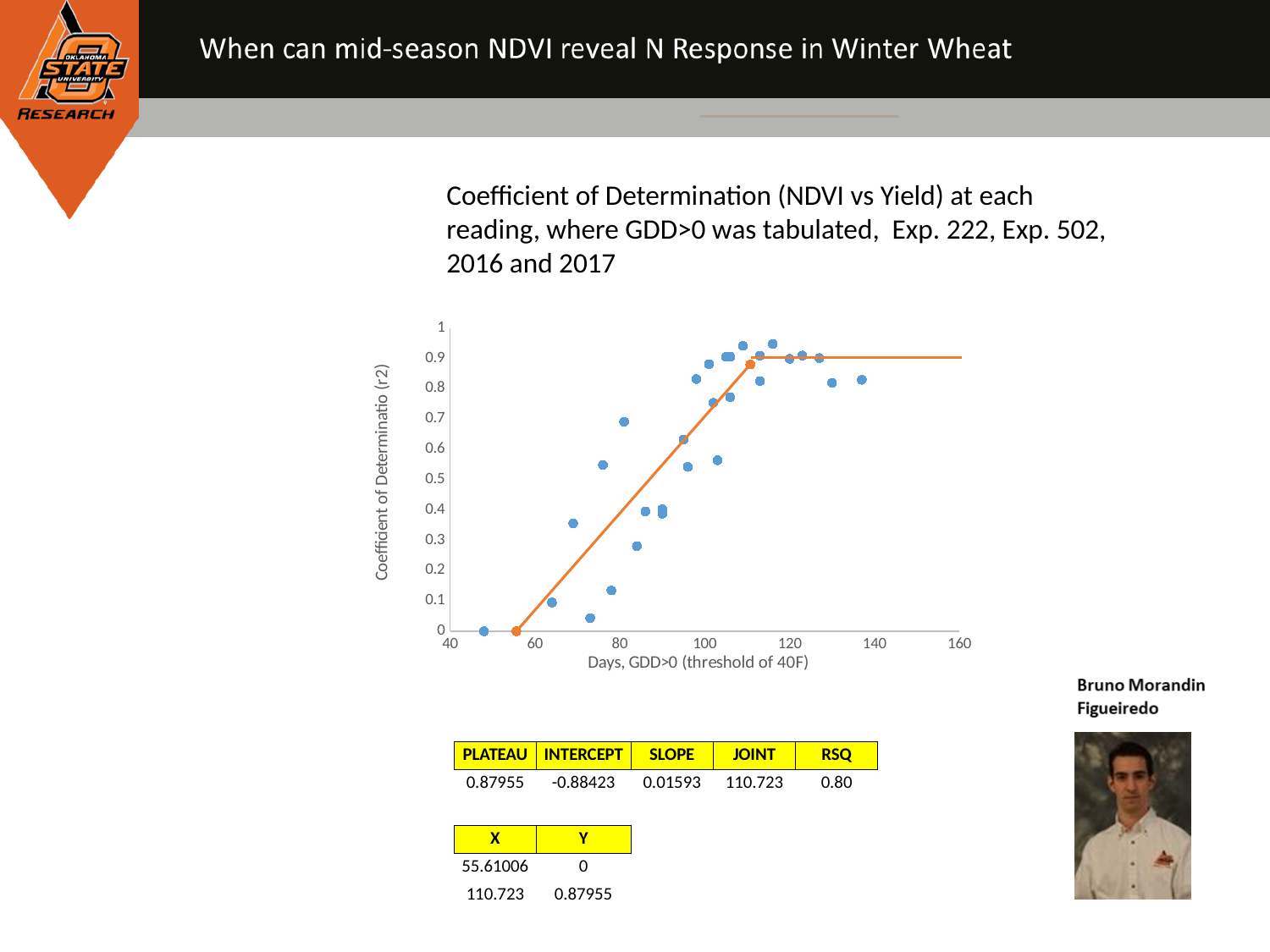
According to the table below the chart, what is the PLATEAU value of the fitted line? 0.87955 What kind of chart is shown on the slide? scatter chart Is the coefficient of determination for the point at about 80 days greater or less than 0.8? less What is the highest tick value shown on the x axis of the chart? 160 Is the coefficient of determination for the point at about 70 days greater or less than 0.5? less Do the coefficient of determination values generally rise or fall as days increase from 40 to 110? rise Is the coefficient of determination for the point at about 85 days greater or less than 0.5? less According to the table below the chart, at what JOINT value (days) does the fitted line reach its plateau? 110.723 Which is larger: the coefficient of determination at about 48 days or at about 115 days? about 115 days What is the title of the x axis of the chart? Days, GDD>0 (threshold of 40F)